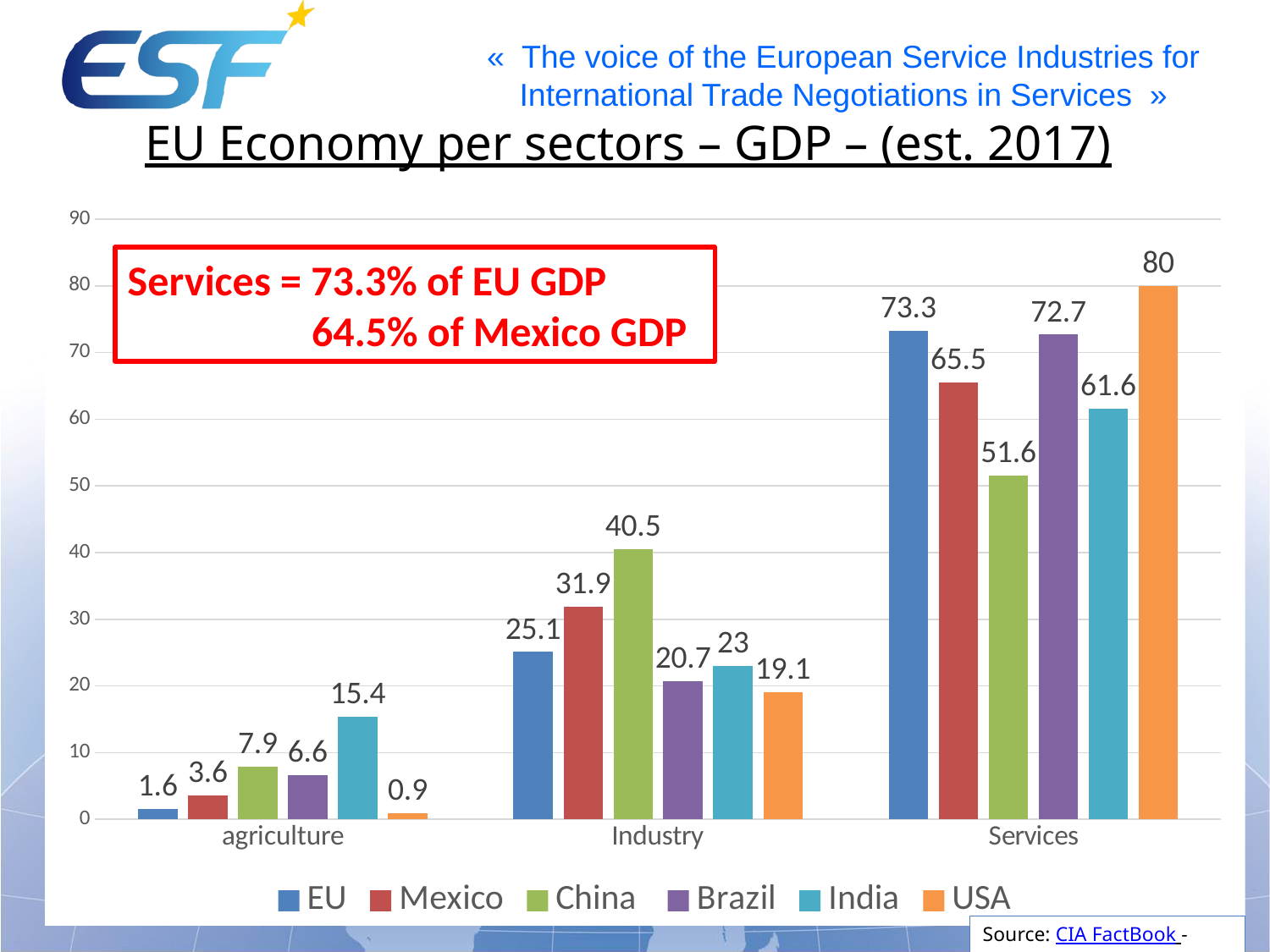
Is the value for China in the Services category greater or less than 50? greater What kind of chart is shown on the slide? bar chart What is the difference between the USA and EU values in the Services category? 6.7 Which is larger in the Industry category, the value for Mexico or the value for Brazil? Mexico Which series has the lowest value in the agriculture category? USA What is the value for China in the Industry category? 40.5 What is the title of the chart? EU Economy per sectors – GDP – (est. 2017) How many categories are shown on the x axis? 3 What is the value for the EU in the Services category? 73.3 How many series does the legend list? 6 Which series has the highest value in the Services category? USA What is the value for India in the agriculture category? 15.4